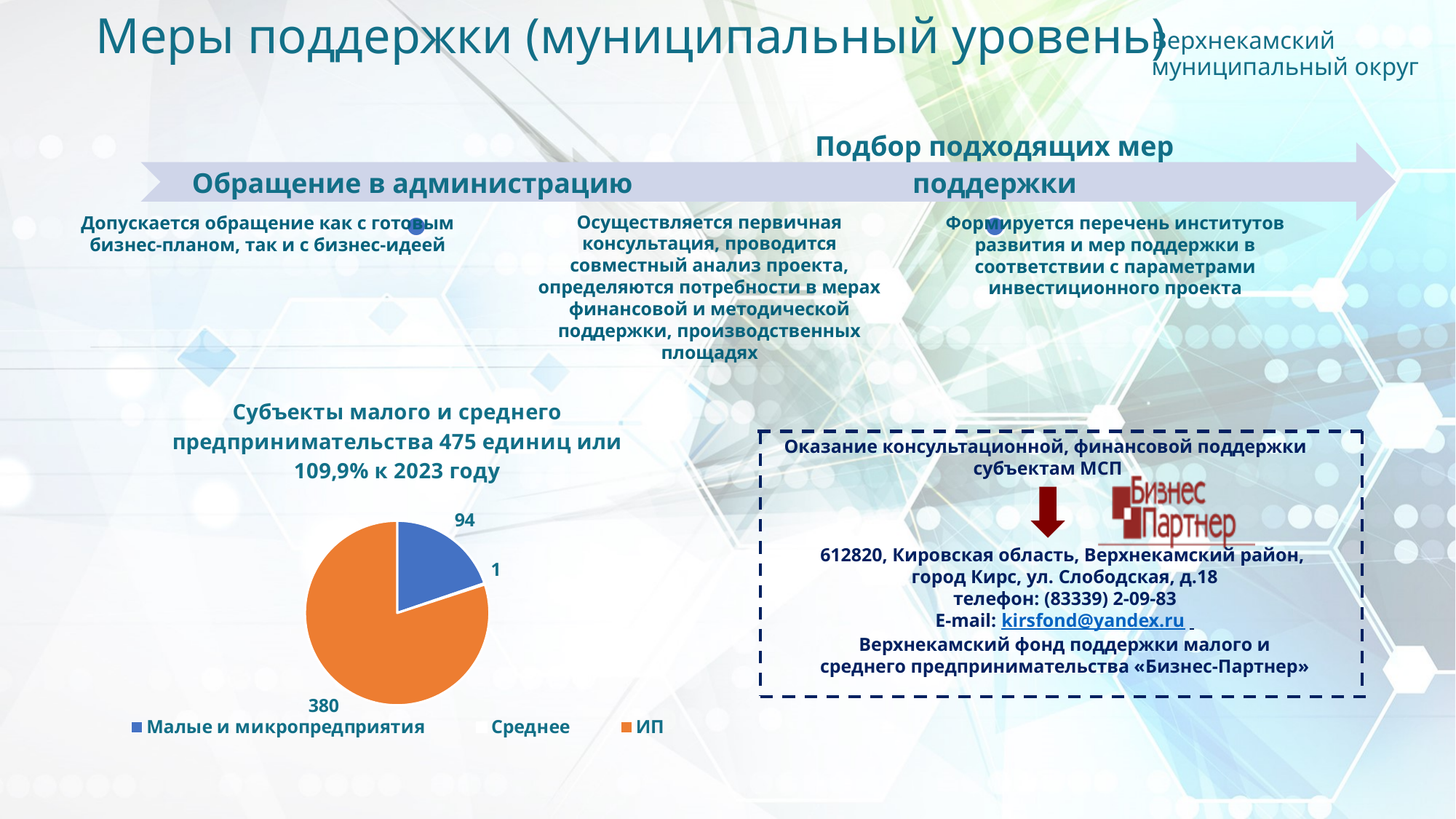
What is the difference between the values for ИП and Малые и микропредприятия? 286 What kind of chart is shown on the slide? pie chart How many categories does the pie chart show? 3 Which is larger, the value for Малые и микропредприятия or the value for Среднее? Малые и микропредприятия Which category has the smallest slice in the pie chart? Среднее What is the value for Среднее in the pie chart? 1 What is the value for Малые и микропредприятия in the pie chart? 94 Which category has the largest slice in the pie chart? ИП What is the total of all slices in the pie chart? 475 According to the chart heading, what percentage relative to 2023 do the 475 units represent? 109,9% What colour is the ИП slice in the pie chart? orange What is the value for ИП in the pie chart? 380